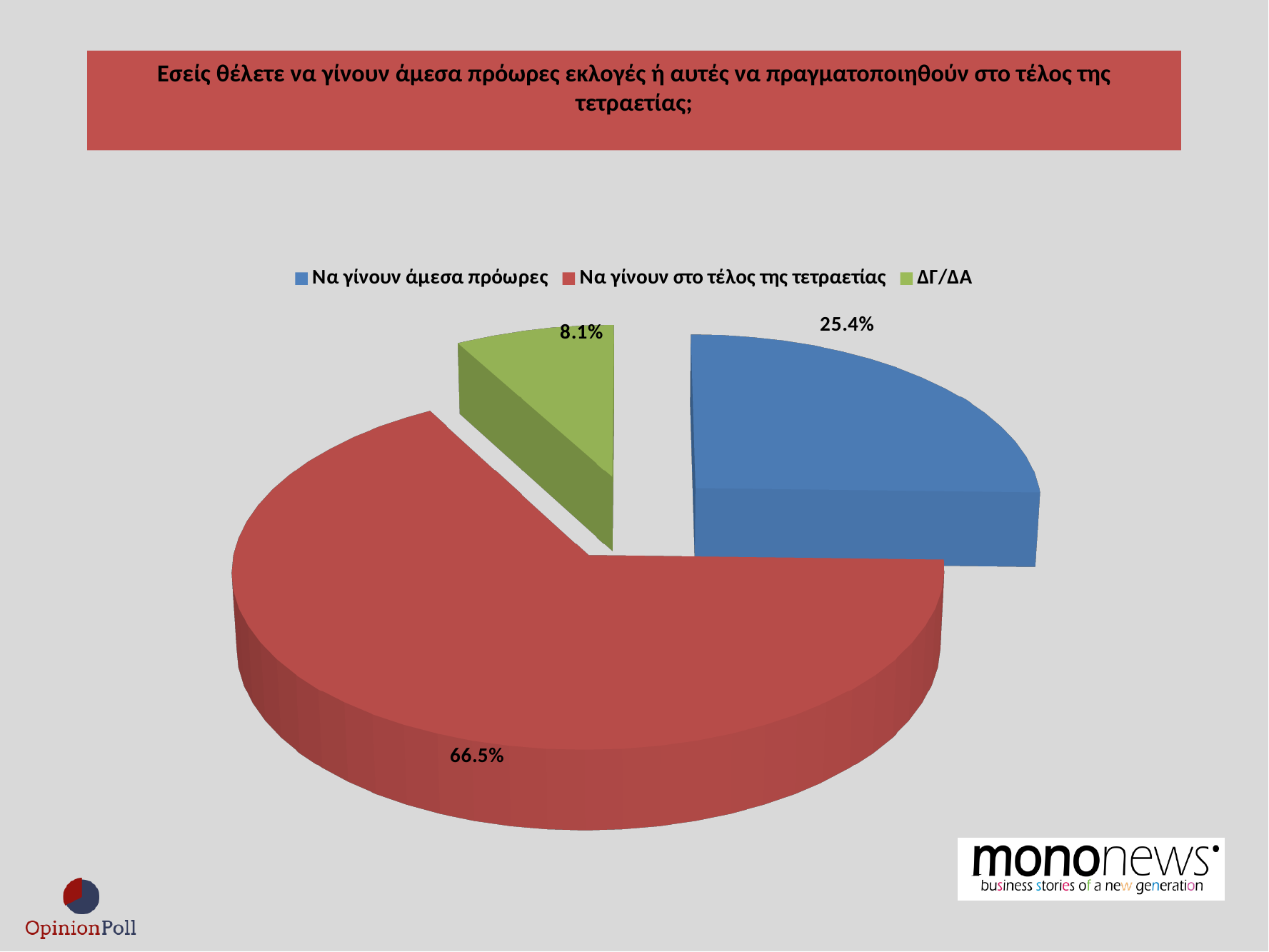
What percentage of respondents chose "Να γίνουν άμεσα πρόωρες"? 25.4% Which is larger: the share for "Να γίνουν άμεσα πρόωρες" or the share for "ΔΓ/ΔΑ"? Να γίνουν άμεσα πρόωρες Which category has the smallest share of the pie? ΔΓ/ΔΑ What is the difference in percentage points between "Να γίνουν στο τέλος της τετραετίας" and "Να γίνουν άμεσα πρόωρες"? 41.1 What percentage of respondents chose "Να γίνουν στο τέλος της τετραετίας"? 66.5% How many entries does the legend list? 3 What colour is the slice for "ΔΓ/ΔΑ"? Green What percentage of respondents answered "ΔΓ/ΔΑ"? 8.1% How many slices does the pie chart have? 3 Which category has the largest share of the pie? Να γίνουν στο τέλος της τετραετίας What is the difference in percentage points between "Να γίνουν άμεσα πρόωρες" and "ΔΓ/ΔΑ"? 17.3 What kind of chart is shown on the slide? Pie chart